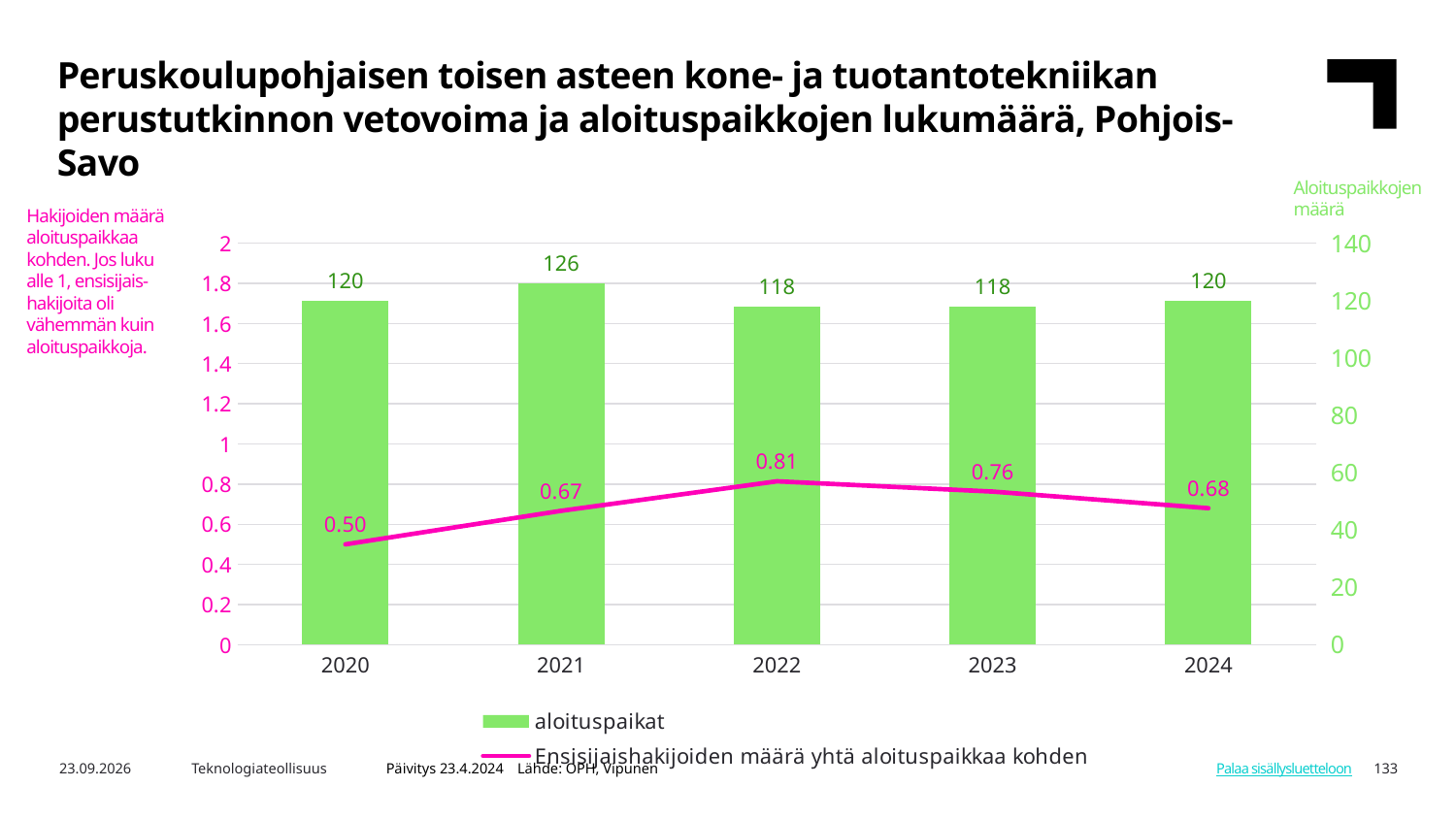
In which year is Ensisijaishakijoiden määrä yhtä aloituspaikkaa kohden highest? 2022 What is the difference between aloituspaikat in 2021 and in 2022? 8 In which year is aloituspaikat highest? 2021 What is the difference between Ensisijaishakijoiden määrä yhtä aloituspaikkaa kohden in 2022 and in 2020? 0.31 How many years are shown on the x axis of the chart? 5 What is the value of aloituspaikat for 2021? 126 What is the value of aloituspaikat for 2024? 120 What is the value of Ensisijaishakijoiden määrä yhtä aloituspaikkaa kohden for 2022? 0.81 Does Ensisijaishakijoiden määrä yhtä aloituspaikkaa kohden rise or fall from 2020 to 2022? rise Which year has a larger value of Ensisijaishakijoiden määrä yhtä aloituspaikkaa kohden, 2023 or 2024? 2023 How many series does the legend list? 2 In which year is Ensisijaishakijoiden määrä yhtä aloituspaikkaa kohden lowest? 2020